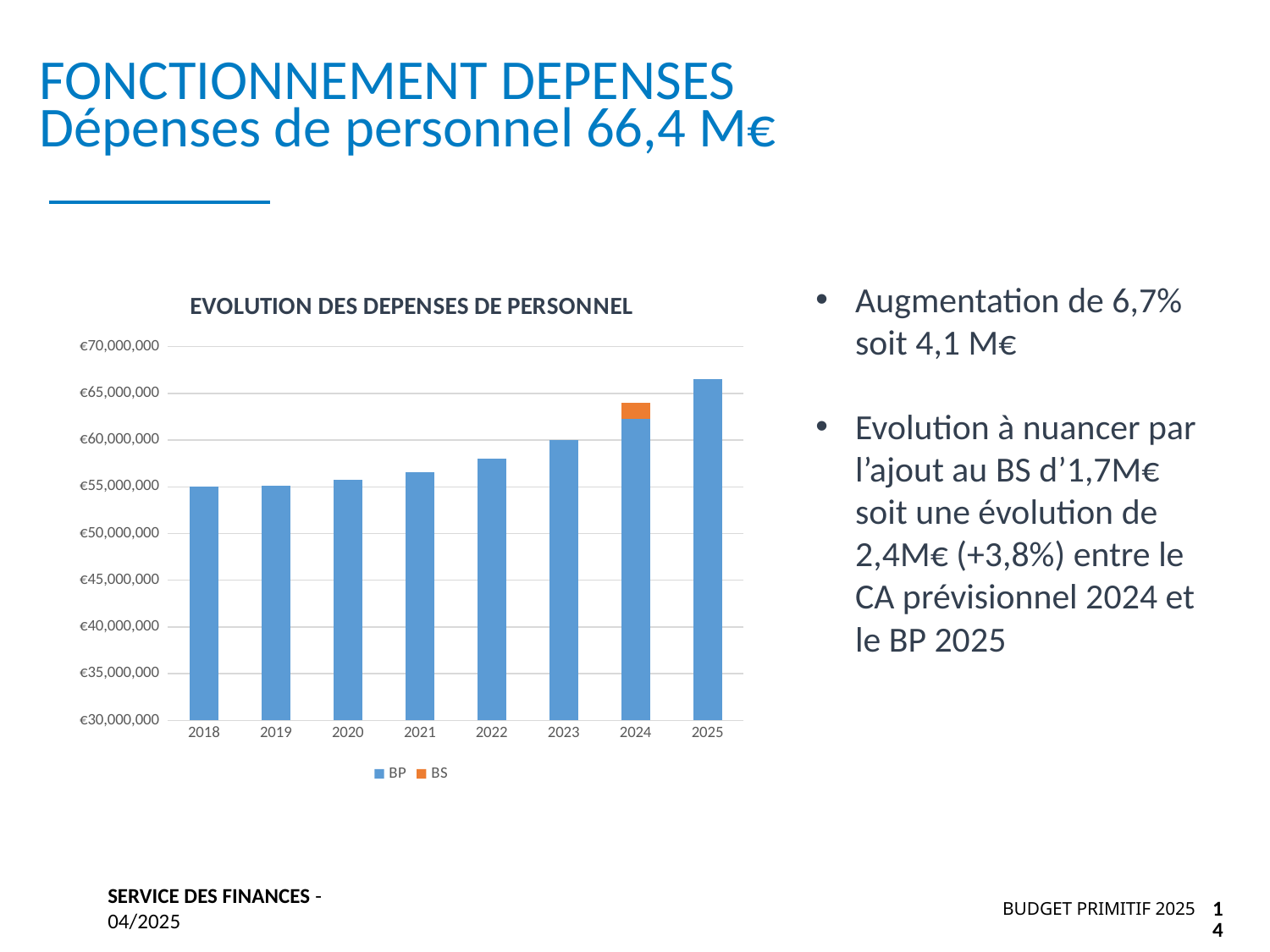
Is the BP value for 2024 greater or less than €60,000,000? greater Is the value for 2021 greater or less than €55,000,000? greater What kind of chart is shown on the slide? bar chart Is the value for 2022 greater or less than €60,000,000? less What is the title of the chart? EVOLUTION DES DEPENSES DE PERSONNEL Which year has the highest total bar in the chart? 2025 Which is larger, the bar for 2023 or the bar for 2021? 2023 Do the values generally rise or fall from 2018 to 2025? rise How many series does the chart legend list? 2 Which year is the only one with an orange BS segment in the chart? 2024 How many years are shown on the x axis of the chart? 8